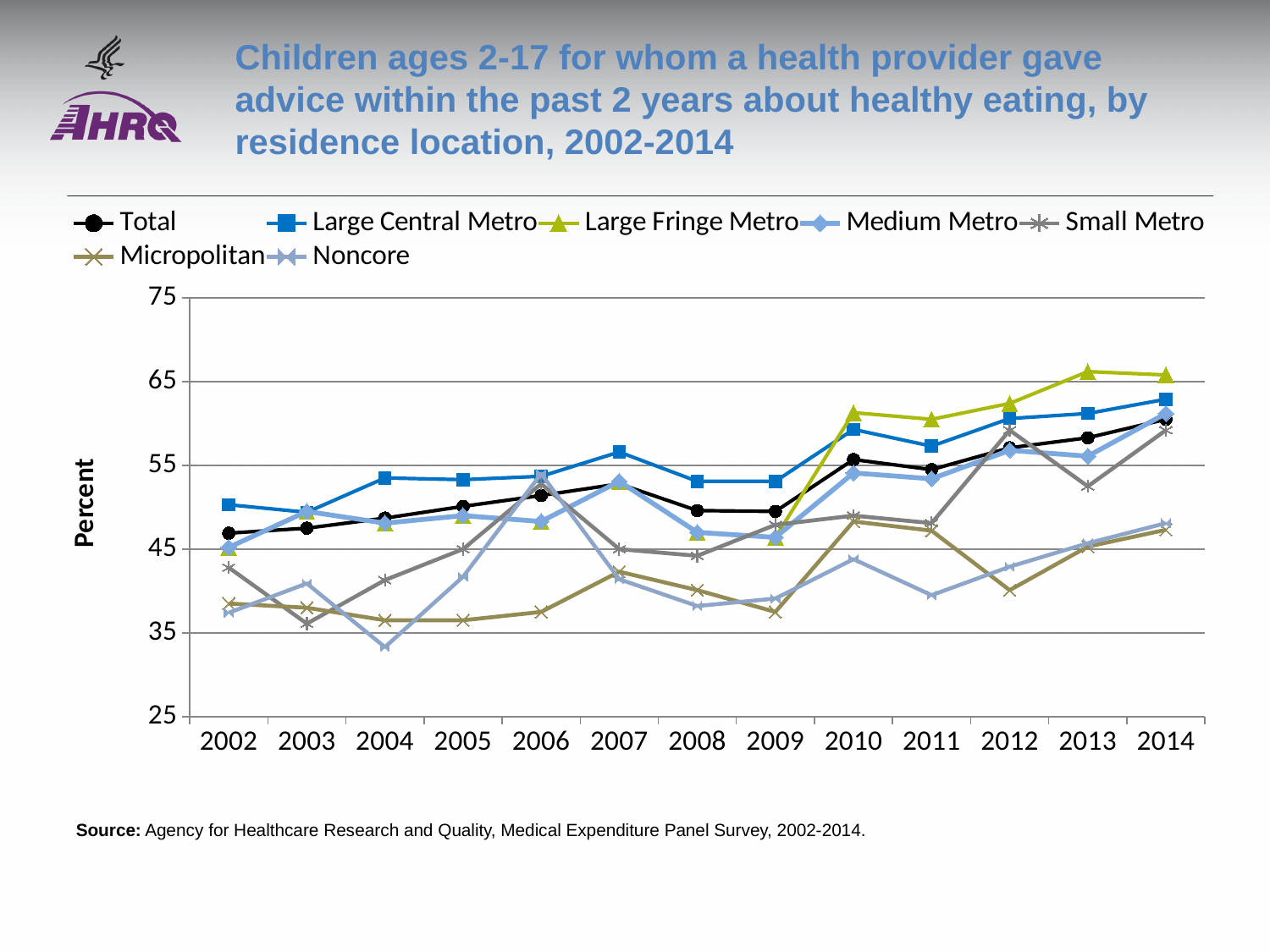
In 2012, which is larger: Small Metro or Micropolitan? Small Metro What is the label on the y axis? Percent In 2013, which is larger: Large Fringe Metro or Large Central Metro? Large Fringe Metro How many series does the legend list? 7 Does the Total series generally rise or fall from 2002 to 2014? Rise Which series has the highest value in 2014? Large Fringe Metro Is the value for Noncore in 2004 greater or less than 35? less Is the value for Micropolitan in 2012 greater or less than 45? less What kind of chart is shown on the slide? Line chart Which series has the lowest value in 2004? Noncore Is the value for Large Fringe Metro in 2014 greater or less than 65? greater How many years are plotted along the x axis? 13